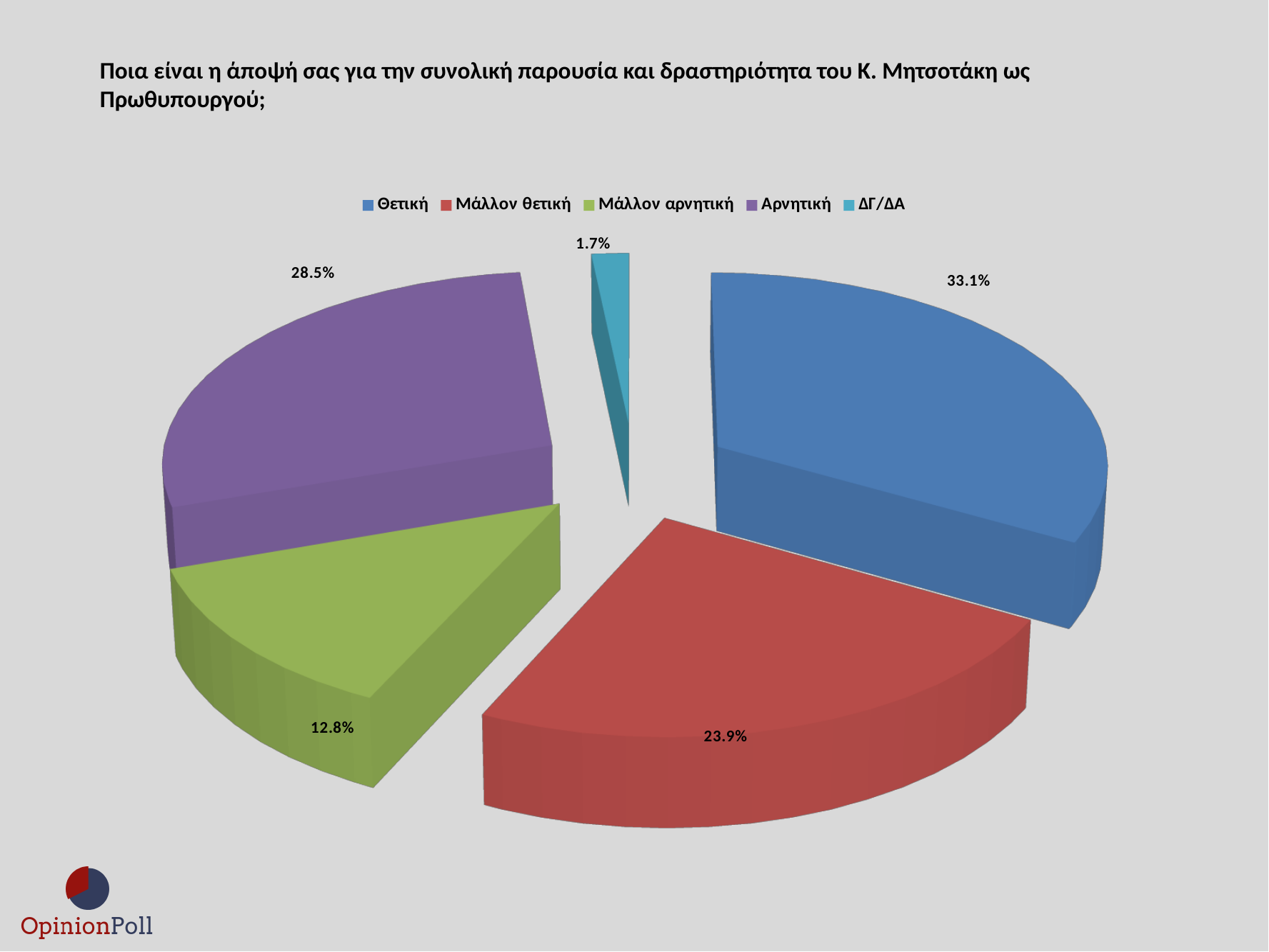
What is the value of the ΔΓ/ΔΑ slice? 1.7% How many slices does the pie chart have? 5 Which category has the largest share of the pie? Θετική What is the difference in percentage points between Θετική and Αρνητική? 4.6 What percentage of respondents answered Θετική? 33.1% What percentage is shown for Αρνητική? 28.5% Which is larger, the Αρνητική slice or the Μάλλον θετική slice? Αρνητική Which category has the smallest share of the pie? ΔΓ/ΔΑ What type of chart is shown on the slide? Pie chart What colour is the Μάλλον αρνητική slice? Green What is the difference in percentage points between Μάλλον θετική and Μάλλον αρνητική? 11.1 What is the value shown for the Μάλλον θετική slice? 23.9%